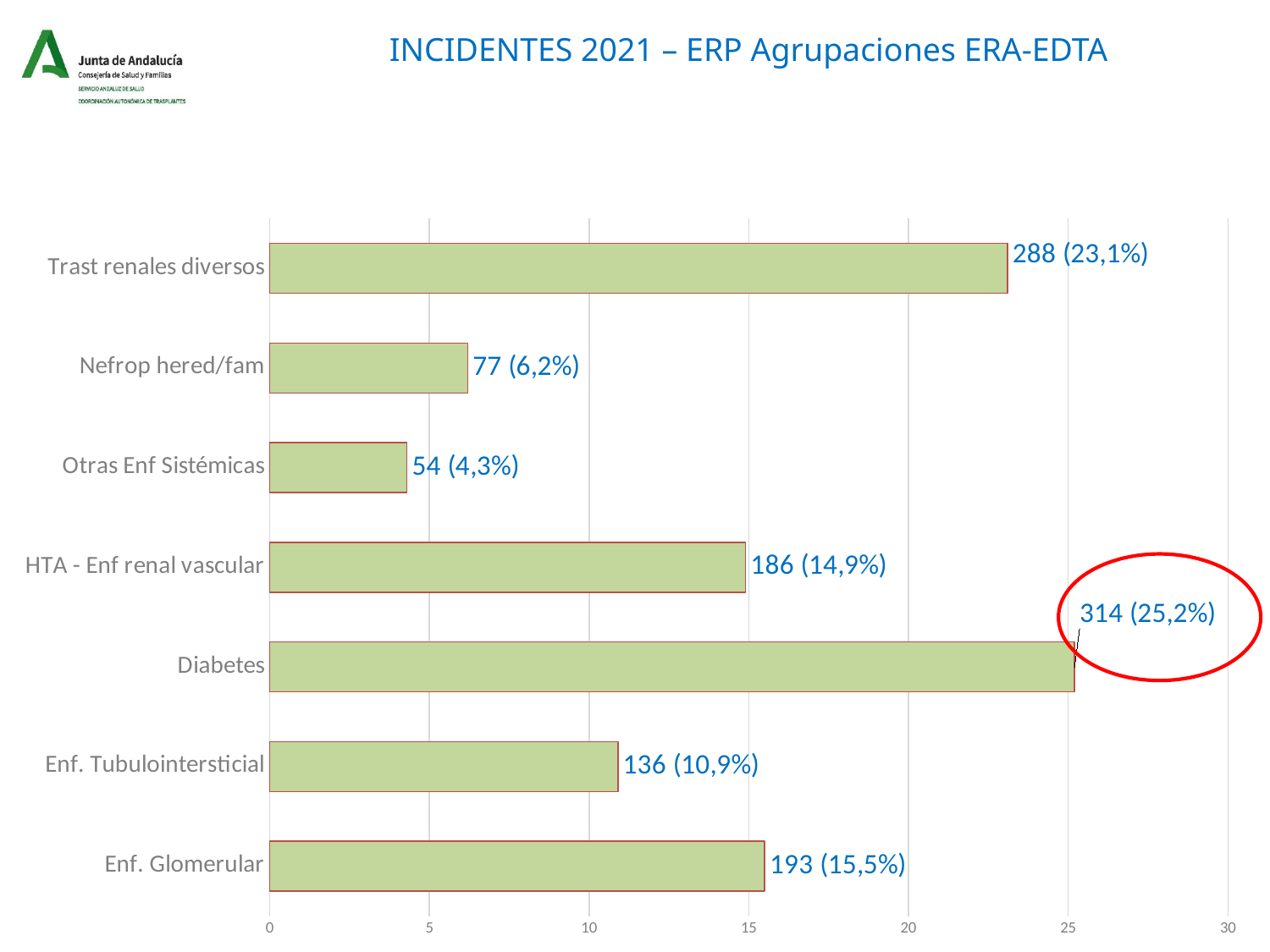
Which is larger, the value for HTA - Enf renal vascular or the value for Enf. Tubulointersticial? HTA - Enf renal vascular Which category has the lowest value? Otras Enf Sistémicas Is the percentage for Nefrop hered/fam greater or less than 10? less What is the data label shown for Enf. Glomerular? 193 (15,5%) What is the difference in count between Diabetes (314) and Trast renales diversos (288)? 26 What kind of chart is shown on the slide? bar chart Which category has the highest value? Diabetes What is the data label shown for Diabetes? 314 (25,2%) Which category's data label is circled in red? Diabetes What is the title of the slide? INCIDENTES 2021 – ERP Agrupaciones ERA-EDTA What is the data label shown for Otras Enf Sistémicas? 54 (4,3%) How many categories are shown in the chart? 7